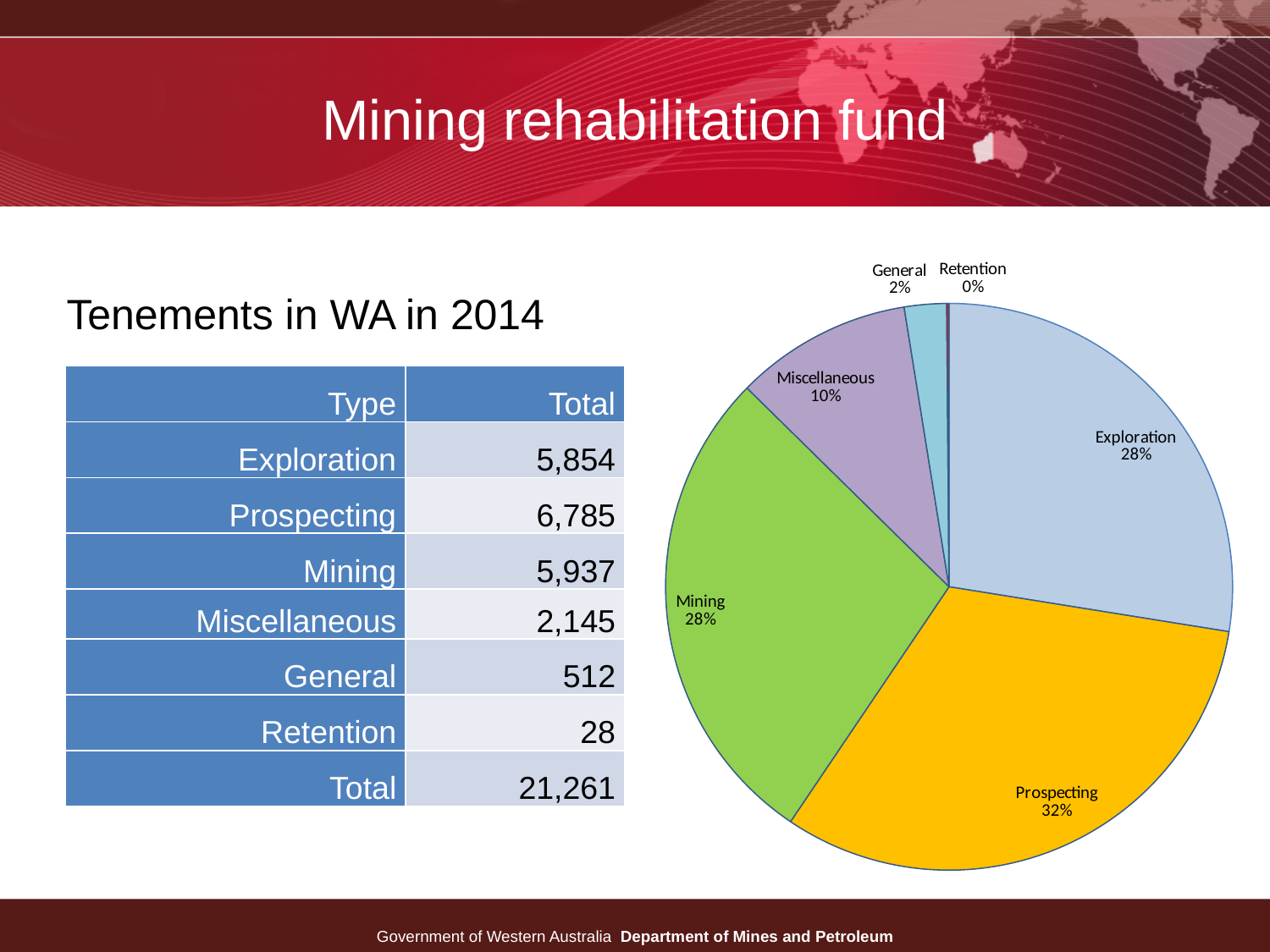
What percentage is shown for the Exploration slice of the pie chart? 28% What is the heading above the table next to the pie chart? Tenements in WA in 2014 How many slices does the pie chart have? 6 How many percentage points larger is the Prospecting slice than the Miscellaneous slice? 22 What kind of chart is shown on the slide? pie chart Which slice is larger in the pie chart, Prospecting or Miscellaneous? Prospecting Which category has the smallest slice of the pie chart? Retention What percentage is shown for the General slice of the pie chart? 2% Which category has the largest slice of the pie chart? Prospecting What percentage is shown for the Retention slice of the pie chart? 0% What percentage of the pie chart does Miscellaneous represent? 10% What percentage of the pie chart does Prospecting represent? 32%